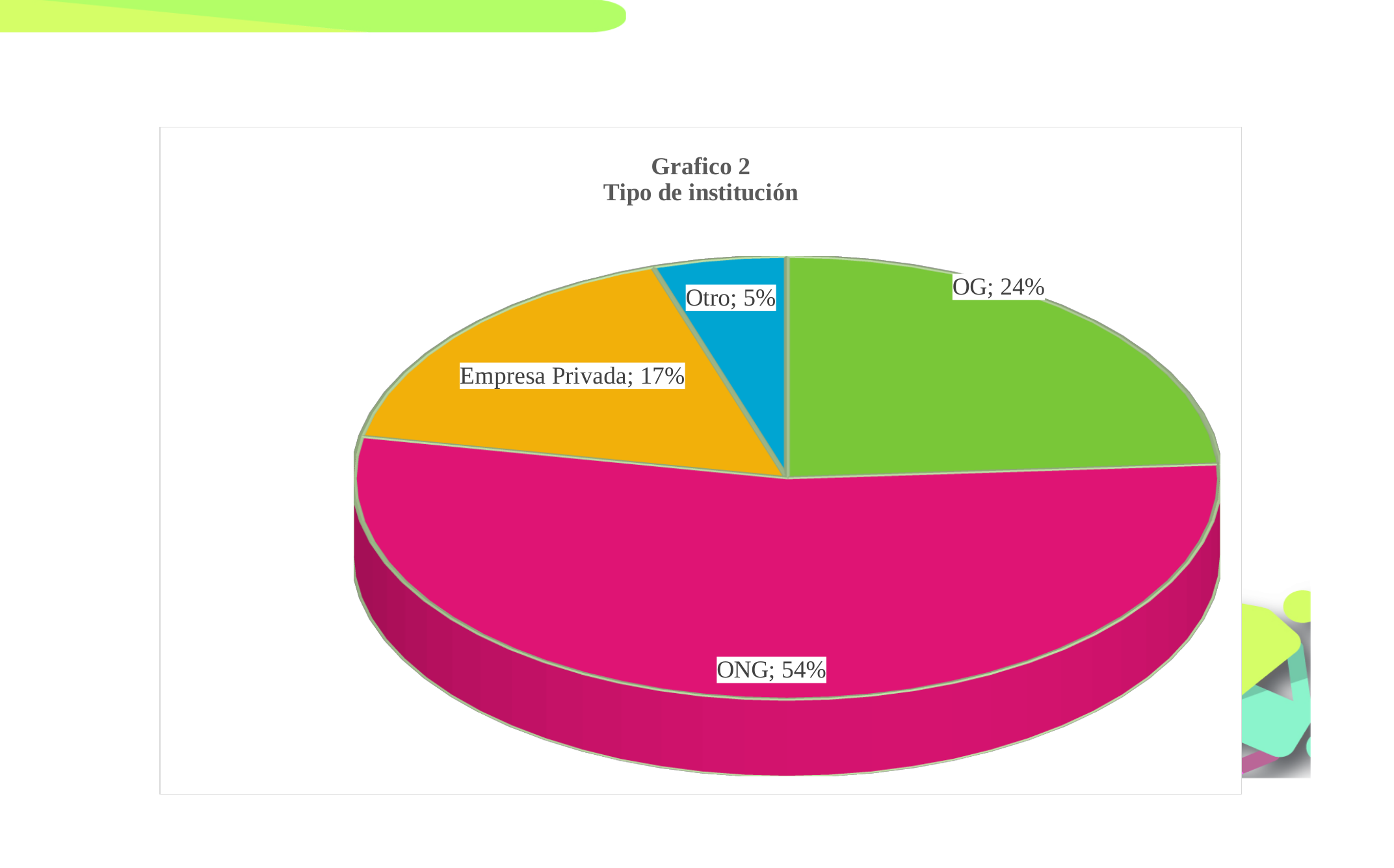
What type of chart is shown on the slide? Pie chart What share of the pie does Empresa Privada represent? 17% What colour is the ONG slice? Pink What share of the pie does OG represent? 24% Which category has the smallest share of the pie? Otro Which is larger, the share for OG or the share for Empresa Privada? OG What share of the pie does Otro represent? 5% What is the difference in percentage points between ONG and OG? 30 How many categories are shown in the pie chart? 4 Which category has the largest share of the pie? ONG What share of the pie does ONG represent? 54% What is the title of the chart? Grafico 2 Tipo de institución